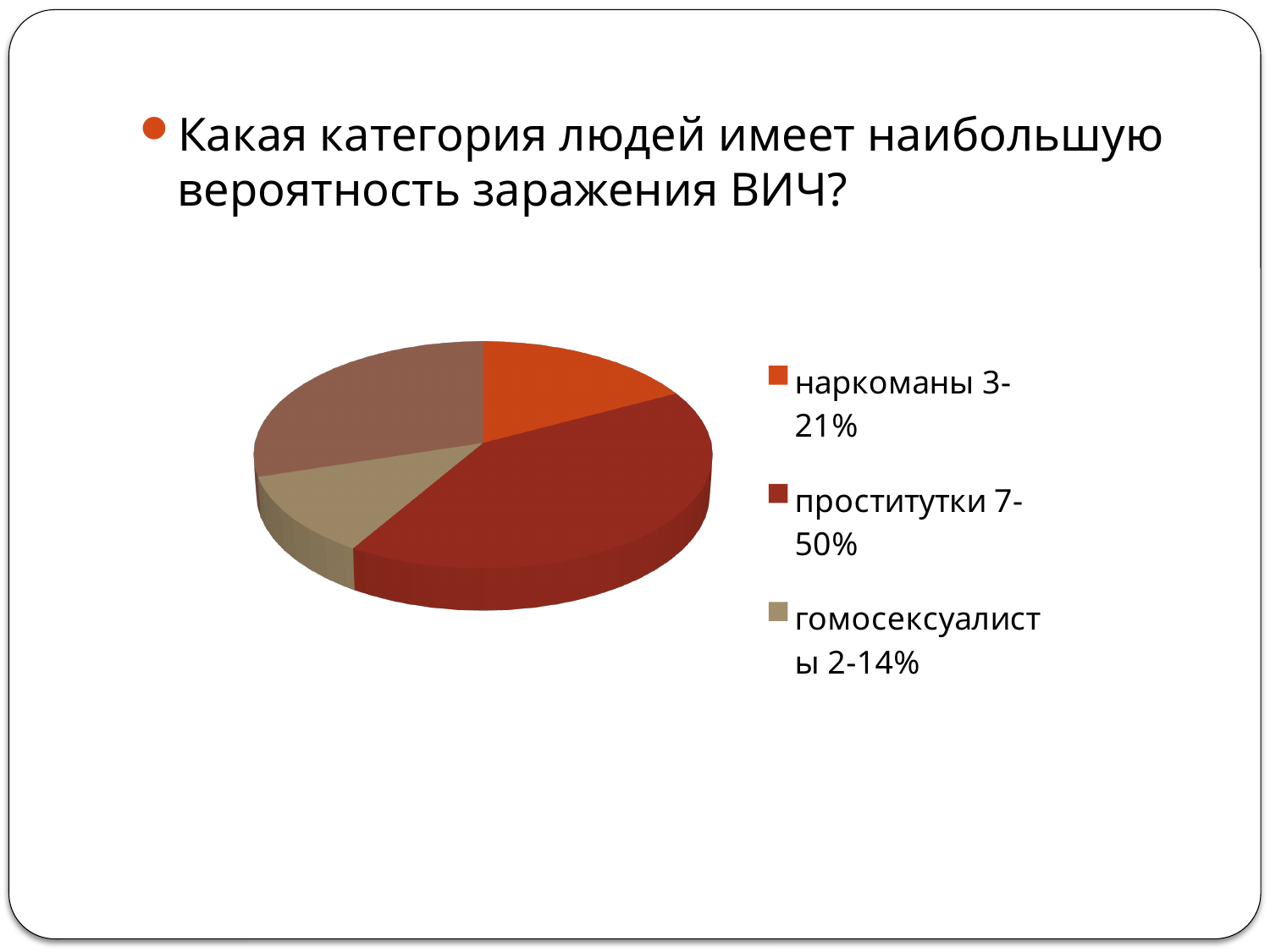
Which legend category is shown in dark red? проститутки 7-50% How many entries does the chart legend list? 3 What range is given in the legend for "гомосексуалисты"? 2-14% Which legend category has the largest slice of the pie? проститутки 7-50% Which slice is larger: the one for "проститутки 7-50%" or the one for "наркоманы 3-21%"? проститутки 7-50% What range is given in the legend for "наркоманы"? 3-21% What kind of chart is shown on the slide? pie chart Which slice is larger: the one for "проститутки 7-50%" or the one for "гомосексуалисты 2-14%"? проститутки 7-50%